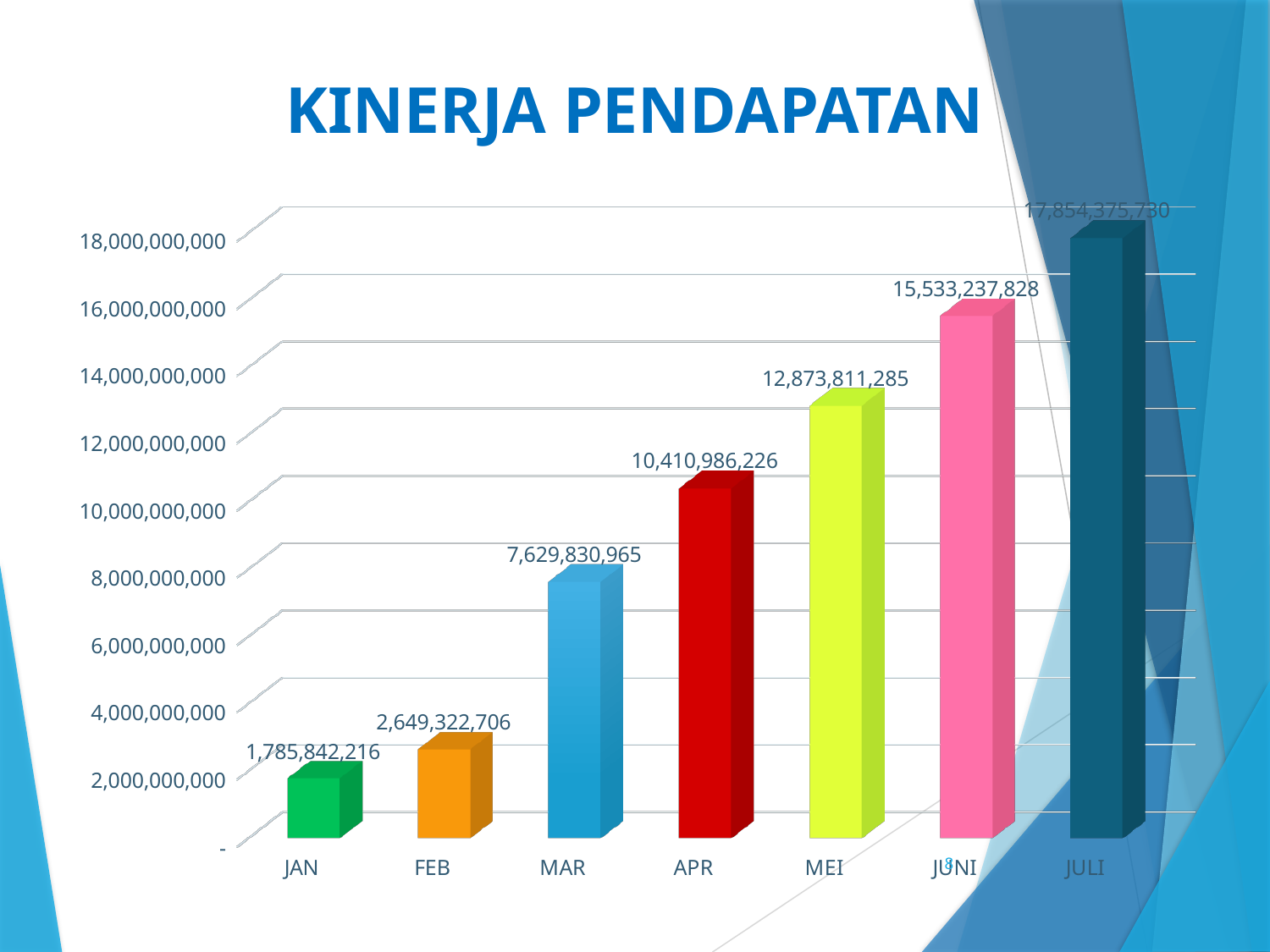
Which month has the highest value? JULI What is the title of the chart? KINERJA PENDAPATAN What is the value for MEI? 12,873,811,285 What kind of chart is shown on the slide? bar chart Do the values rise or fall from JAN to JULI? rise How many months are shown on the x axis of the chart? 7 What is the value for MAR? 7,629,830,965 What is the difference between the values for APR and MAR? 2,781,155,261 Which month has the lowest value? JAN What is the value for JUNI? 15,533,237,828 What is the value for JAN? 1,785,842,216 What is the difference between the values for FEB and JAN? 863,480,490